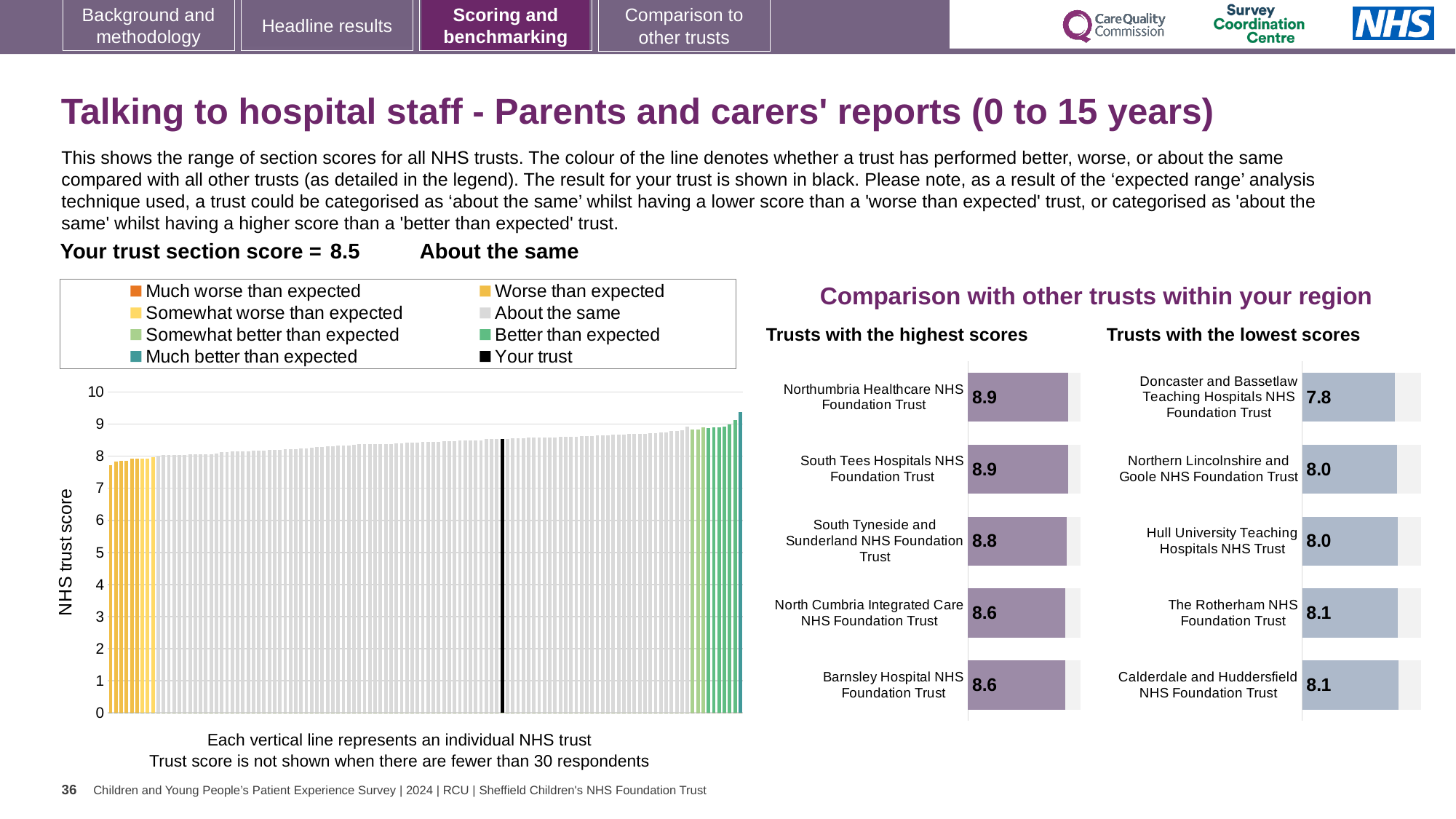
In the 'Trusts with the highest scores' chart, what is the difference between the scores of Northumbria Healthcare NHS Foundation Trust and Barnsley Hospital NHS Foundation Trust? 0.3 In the 'Trusts with the highest scores' chart, what is the score for Northumbria Healthcare NHS Foundation Trust? 8.9 In the 'Trusts with the lowest scores' chart, what is the score for Hull University Teaching Hospitals NHS Trust? 8.0 What is your trust's section score shown on the slide? 8.5 In the left-hand chart, do the trust scores rise or fall from left to right? rise How many entries does the legend of the left-hand chart list? 8 What kind of chart is the left-hand chart showing NHS trust scores? bar chart In the 'Trusts with the highest scores' chart, which has the higher score: South Tyneside and Sunderland NHS Foundation Trust or North Cumbria Integrated Care NHS Foundation Trust? South Tyneside and Sunderland NHS Foundation Trust In the 'Trusts with the lowest scores' chart, which trust has the lowest score? Doncaster and Bassetlaw Teaching Hospitals NHS Foundation Trust In the 'Trusts with the lowest scores' chart, what is the score for Doncaster and Bassetlaw Teaching Hospitals NHS Foundation Trust? 7.8 How many trusts are shown in the 'Trusts with the highest scores' chart? 5 What is the y-axis label of the left-hand chart? NHS trust score